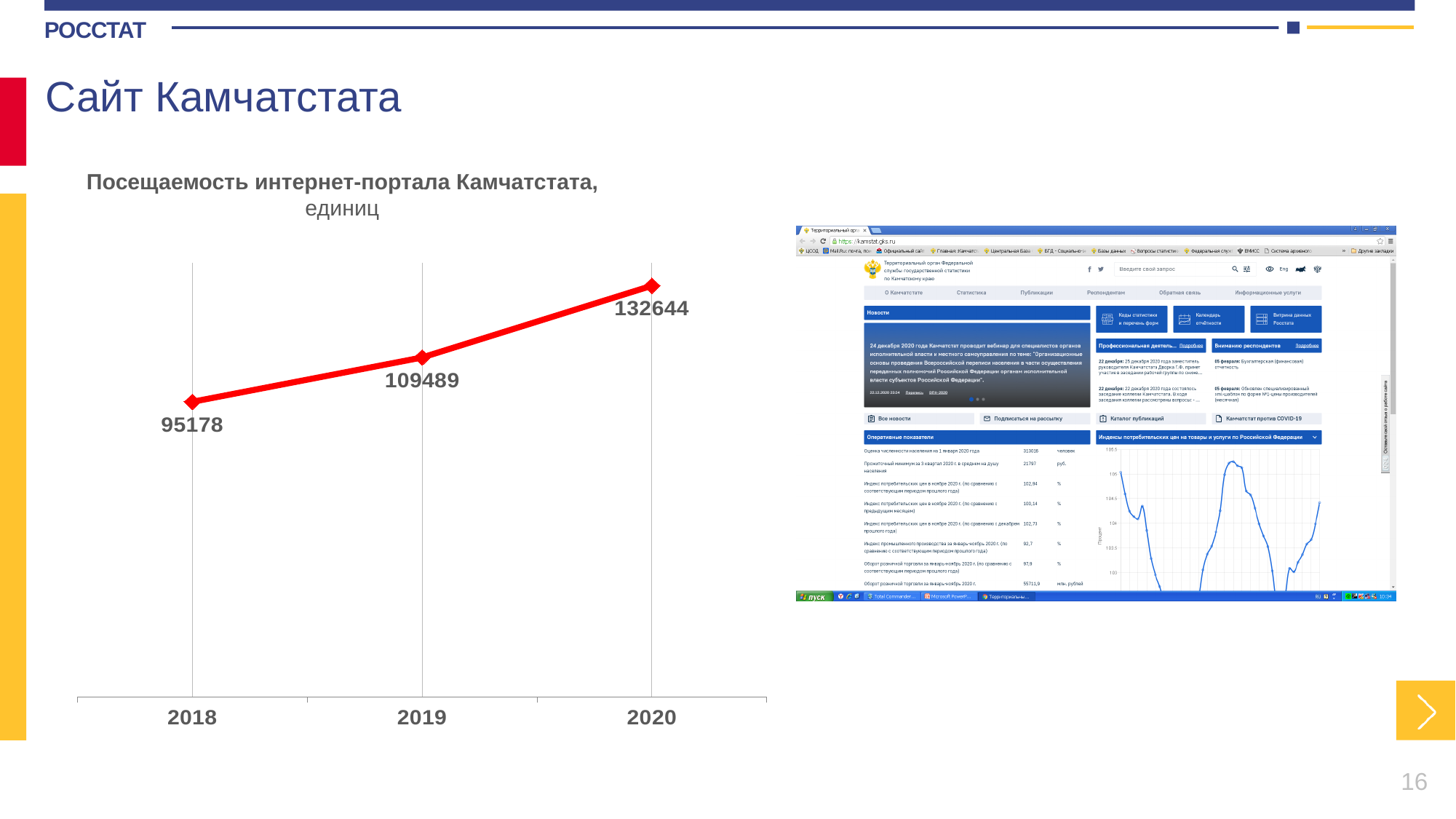
In the chart titled "Посещаемость интернет-портала Камчатстата, единиц", what is the difference between the values for 2020 and 2019? 23155 In the chart titled "Посещаемость интернет-портала Камчатстата, единиц", what is the difference between the values for 2019 and 2018? 14311 In the chart titled "Посещаемость интернет-портала Камчатстата, единиц", what is the value for 2019? 109489 In the chart titled "Посещаемость интернет-портала Камчатстата, единиц", which is larger, the value for 2019 or the value for 2018? 2019 In the chart titled "Посещаемость интернет-портала Камчатстата, единиц", what is the value for 2018? 95178 What kind of chart is the chart titled "Посещаемость интернет-портала Камчатстата, единиц"? line chart In the chart titled "Посещаемость интернет-портала Камчатстата, единиц", by how much did the value increase from 2018 to 2020? 37466 In the chart titled "Посещаемость интернет-портала Камчатстата, единиц", which year has the lowest value? 2018 In the chart titled "Посещаемость интернет-портала Камчатстата, единиц", what is the value for 2020? 132644 How many data points are plotted in the chart titled "Посещаемость интернет-портала Камчатстата, единиц"? 3 In the chart titled "Посещаемость интернет-портала Камчатстата, единиц", do the values rise or fall from 2018 to 2020? rise In the chart titled "Посещаемость интернет-портала Камчатстата, единиц", which year has the highest value? 2020